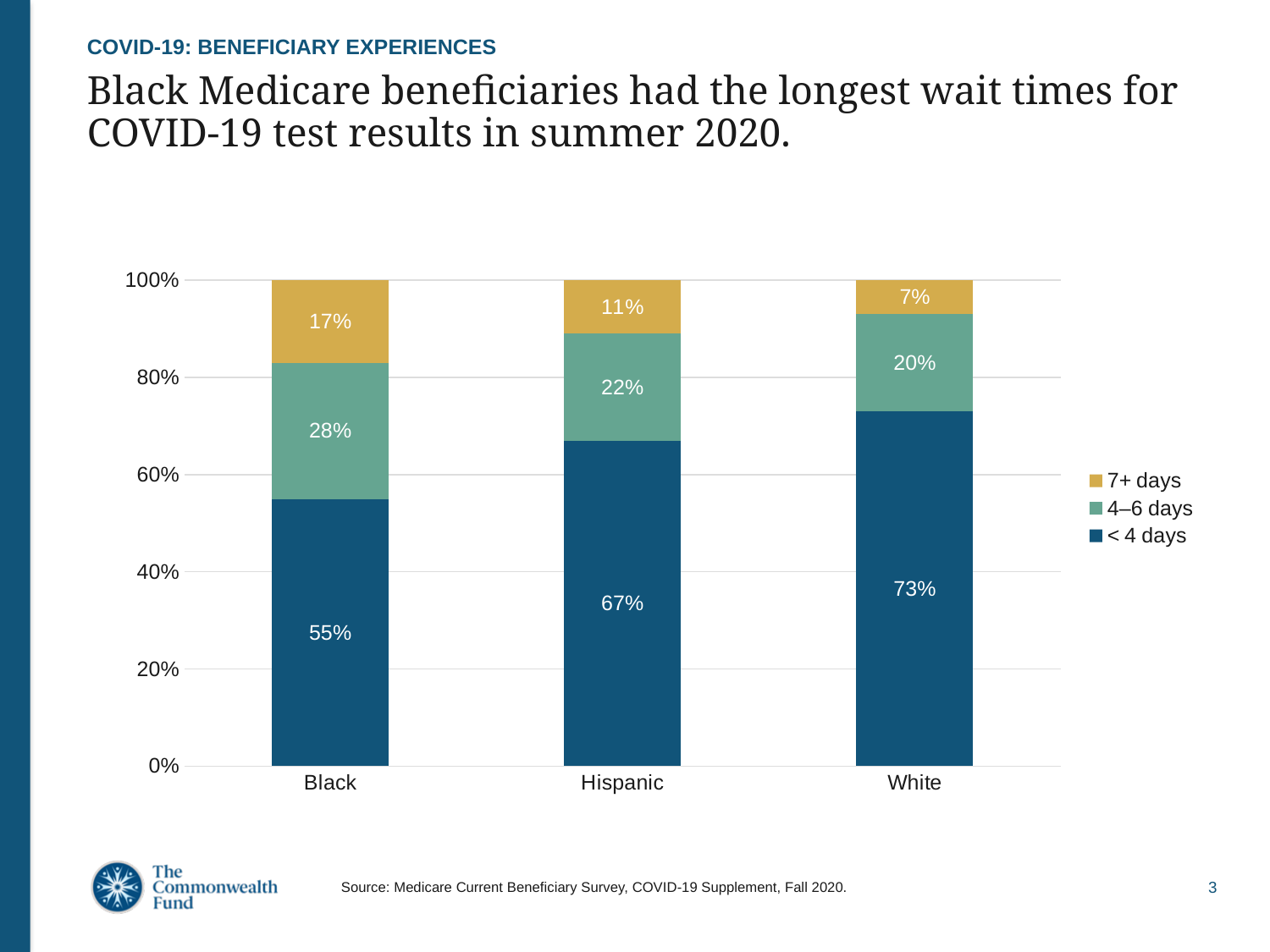
Which is larger: the share of Hispanic beneficiaries waiting 4–6 days or the share of White beneficiaries waiting 4–6 days? Hispanic What percentage of White beneficiaries waited 4–6 days for test results? 20% Which group had the highest share of beneficiaries waiting 7+ days for test results? Black What is the difference between the share of White and Black beneficiaries who waited less than 4 days? 18 percentage points How many racial/ethnic groups are shown on the x axis? 3 Which group had the lowest share of beneficiaries waiting less than 4 days? Black What is the total of the stacked bar for Hispanic beneficiaries? 100% What percentage of Hispanic beneficiaries waited 7+ days for test results? 11% What percentage of Black Medicare beneficiaries waited less than 4 days for COVID-19 test results? 55% Which legend entry is shown in the gold/yellow colour? 7+ days How many series does the legend list? 3 What kind of chart is shown on the slide? Stacked bar chart